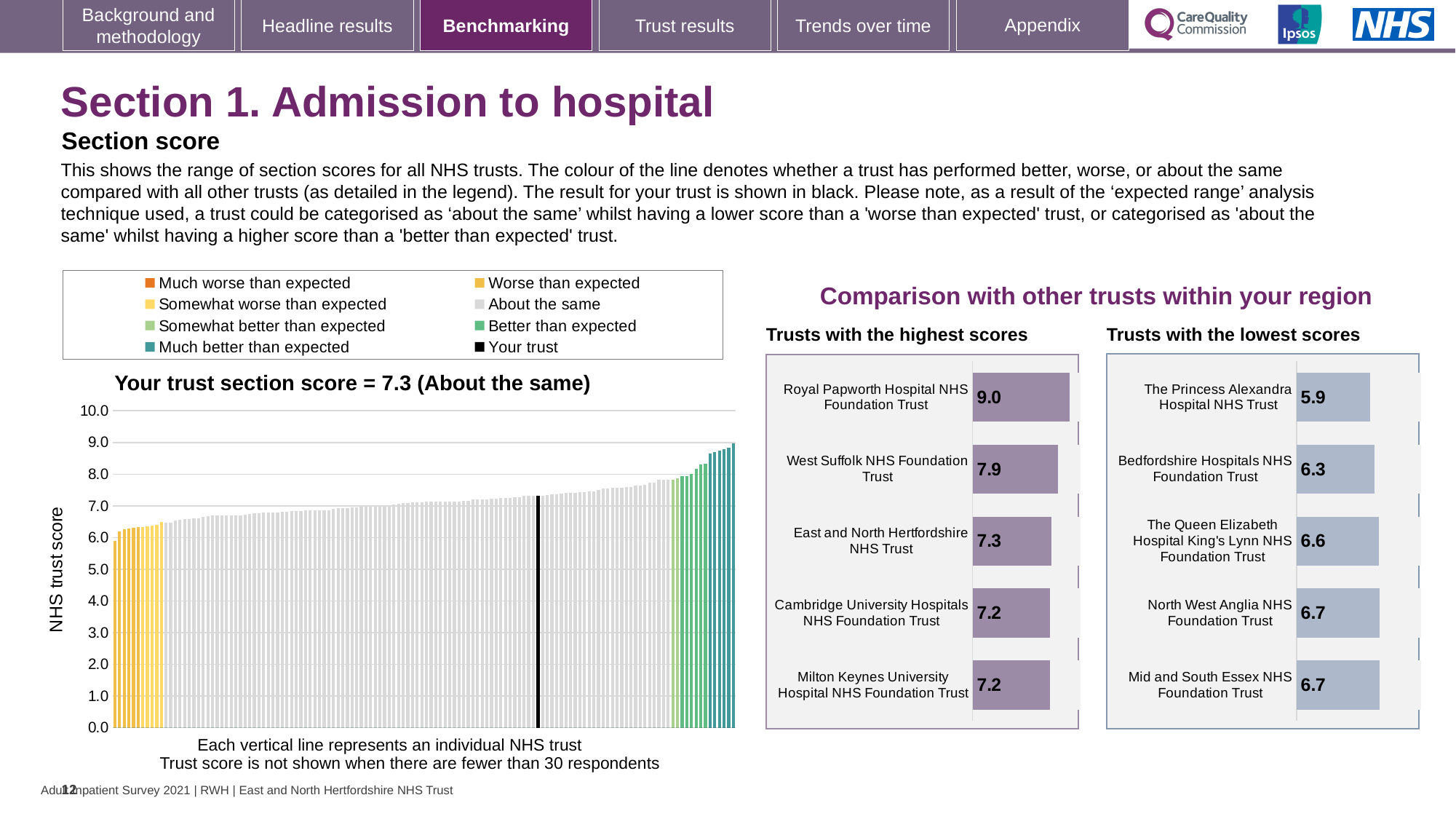
In the 'Your trust section score' chart, what is the section score for your trust? 7.3 In the 'Trusts with the highest scores' chart, what is the score for Royal Papworth Hospital NHS Foundation Trust? 9.0 In the 'Your trust section score' chart, how many entries does the legend list? 8 In the 'Your trust section score' chart, what is the label on the y axis? NHS trust score In the 'Trusts with the highest scores' chart, which has the higher score, West Suffolk NHS Foundation Trust or Cambridge University Hospitals NHS Foundation Trust? West Suffolk NHS Foundation Trust In the 'Your trust section score' chart, do the bar values rise or fall from left to right along the x axis? Rise In the 'Your trust section score' chart, what kind of chart is shown? Bar chart In the 'Trusts with the lowest scores' chart, what is the score for Bedfordshire Hospitals NHS Foundation Trust? 6.3 In the 'Trusts with the lowest scores' chart, which trust has the lowest score? The Princess Alexandra Hospital NHS Trust In the 'Trusts with the highest scores' chart, how many trusts are shown? 5 In the 'Your trust section score' chart, is the value of the tallest bar greater or less than 8.0? greater In the 'Trusts with the highest scores' chart, what is the difference between the scores of Royal Papworth Hospital NHS Foundation Trust and West Suffolk NHS Foundation Trust? 1.1